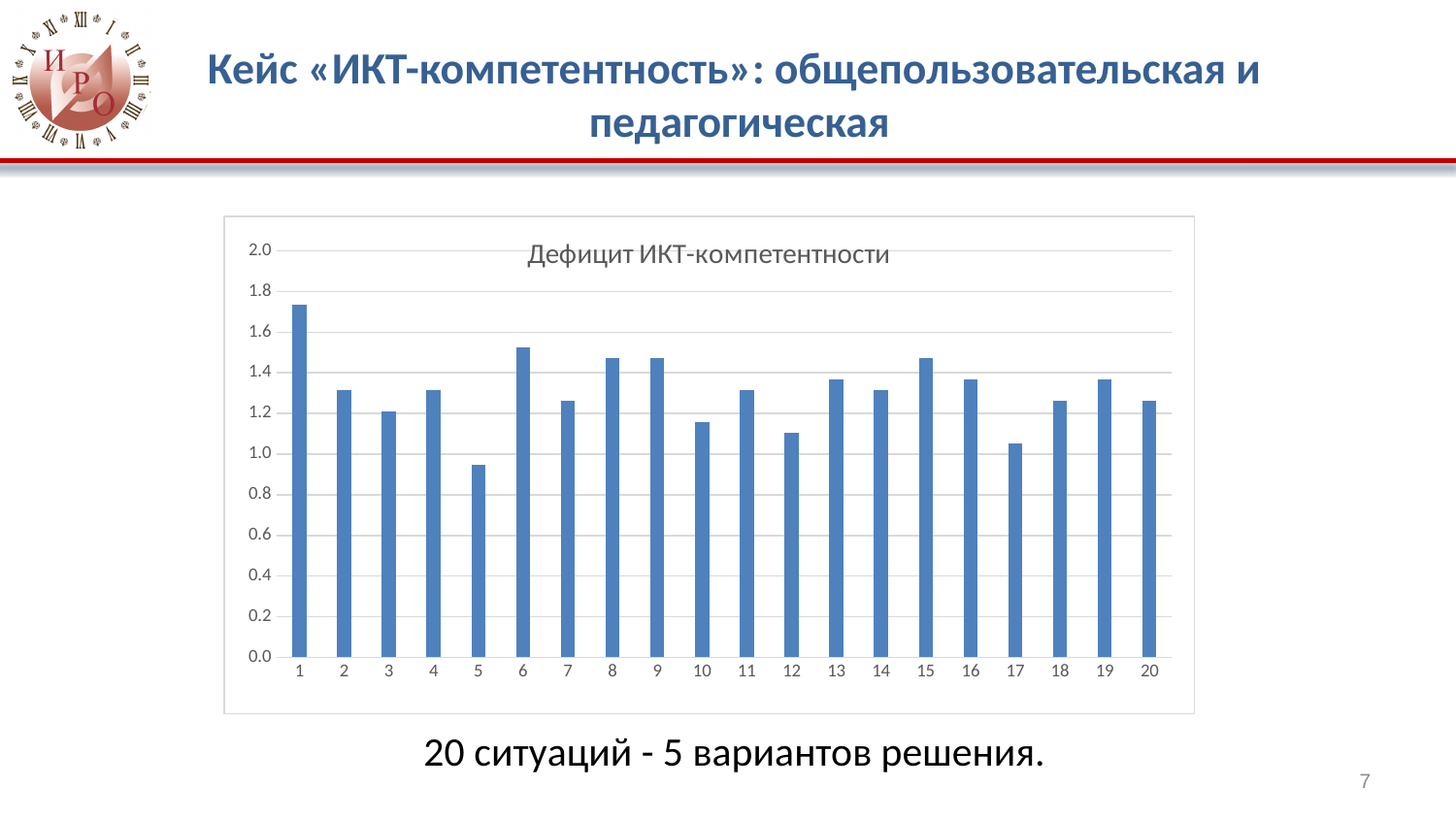
Is the value for category 12 greater or less than 1.2? less What is the title of the chart? Дефицит ИКТ-компетентности What is the highest value shown on the vertical axis of the chart? 2.0 Which is larger, the value for category 10 or the value for category 8? Category 8 How many categories are plotted on the x axis of the chart? 20 Which is larger, the value for category 6 or the value for category 3? Category 6 What kind of chart is shown on the slide? Bar chart Is the value for category 1 greater or less than 1.6? greater Which category has the lowest bar in the chart? 5 Is the value for category 6 greater or less than 1.4? greater Which category has the highest bar in the chart? 1